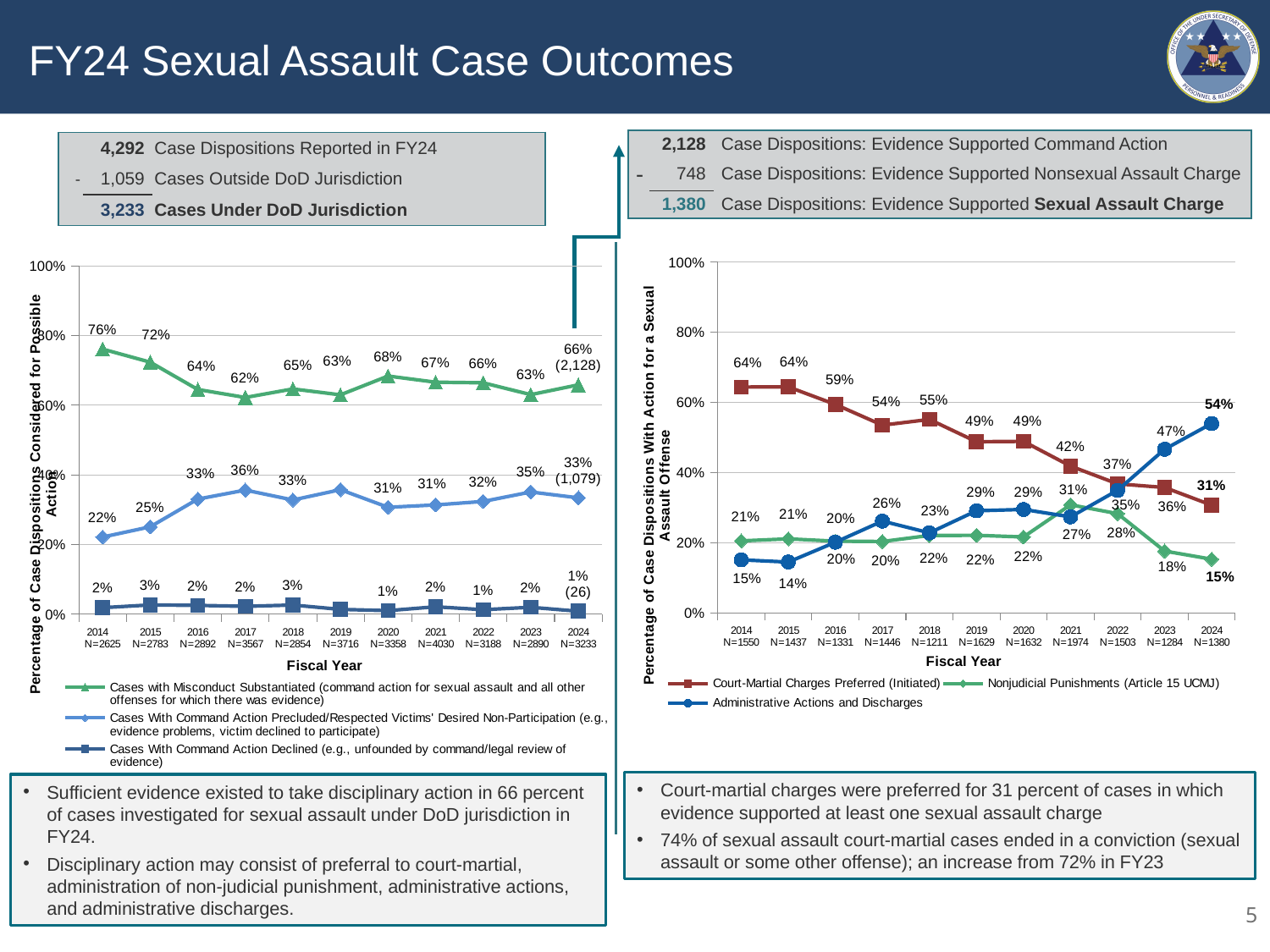
On the right chart, what percentage of case dispositions were court-martial charges preferred in 2024? 31% On the left chart, what percentage of cases had misconduct substantiated in 2014? 76% How many series does the legend of the right chart list? 3 What type of chart is the left chart? Line chart On the right chart, does the percentage of court-martial charges preferred rise or fall from 2014 to 2024? Fall On the left chart, what is the N value shown for fiscal year 2024? N=3233 On the left chart, what percentage of cases had command action declined in 2024? 1% On the right chart, in which year was the percentage of administrative actions and discharges lowest? 2015 On the left chart, what is the difference between the misconduct substantiated percentage in 2014 and in 2024? 10% On the right chart, which was larger in 2024: court-martial charges preferred or administrative actions and discharges? Administrative Actions and Discharges On the left chart, in which year was the percentage of cases with misconduct substantiated highest? 2014 On the right chart, what percentage of case dispositions were administrative actions and discharges in 2023? 47%